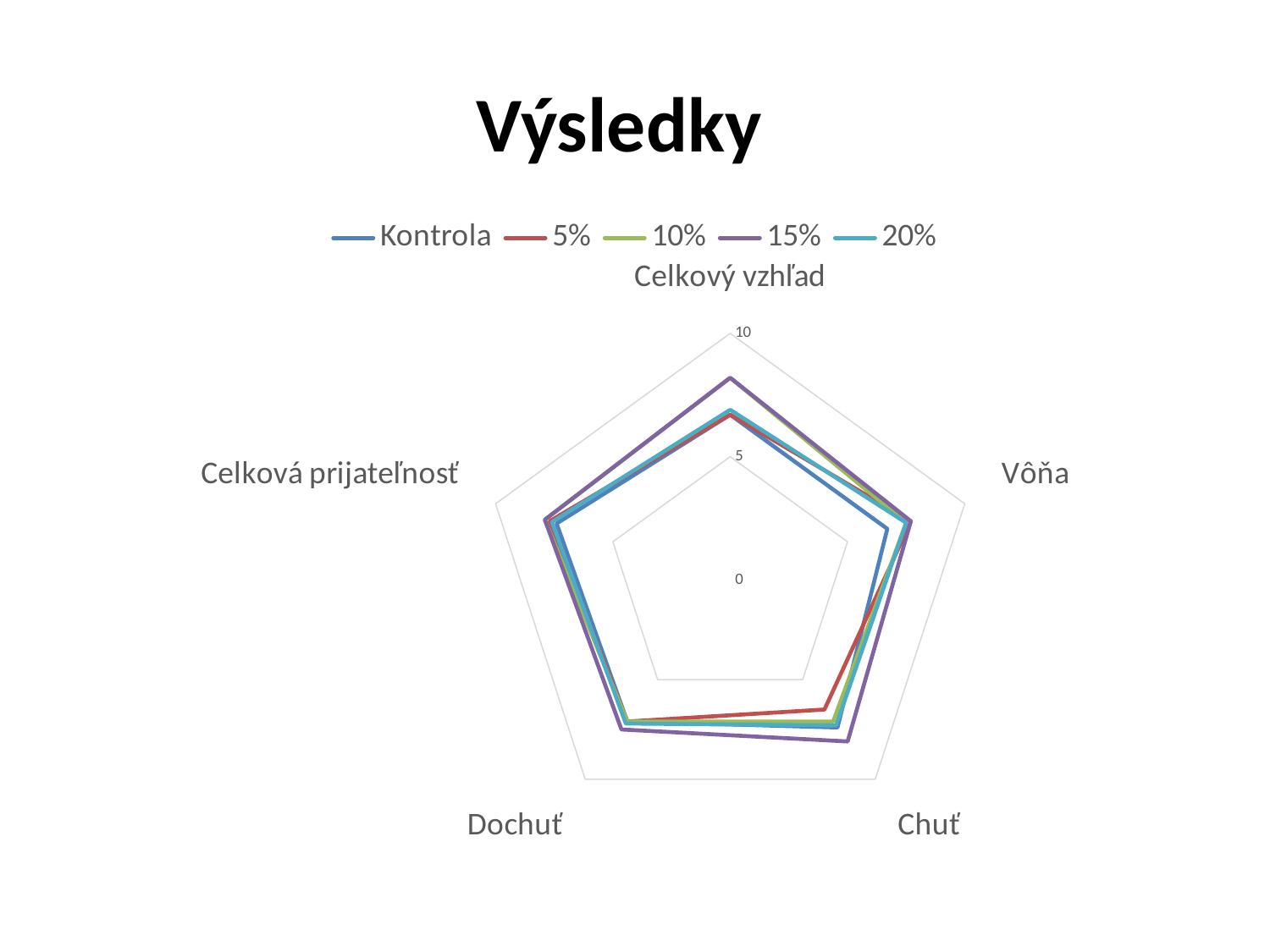
Which category is placed at the top of the radar chart? Celkový vzhľad For Vôňa, which is larger: the value for Kontrola or the value for 15%? 15% Is the value of the 15% series for Celkový vzhľad greater or less than 5? greater For Celkový vzhľad, which is larger: the value for Kontrola or the value for 15%? 15% How many series does the legend list? 5 Which series has the lowest value for Chuť? 5% What kind of chart is shown on the slide? radar chart Is the value of the 5% series for Chuť greater or less than 5? greater Which series has the highest value for Chuť? 15% Which series has the lowest value for Vôňa? Kontrola How many categories (axes) does the radar chart have? 5